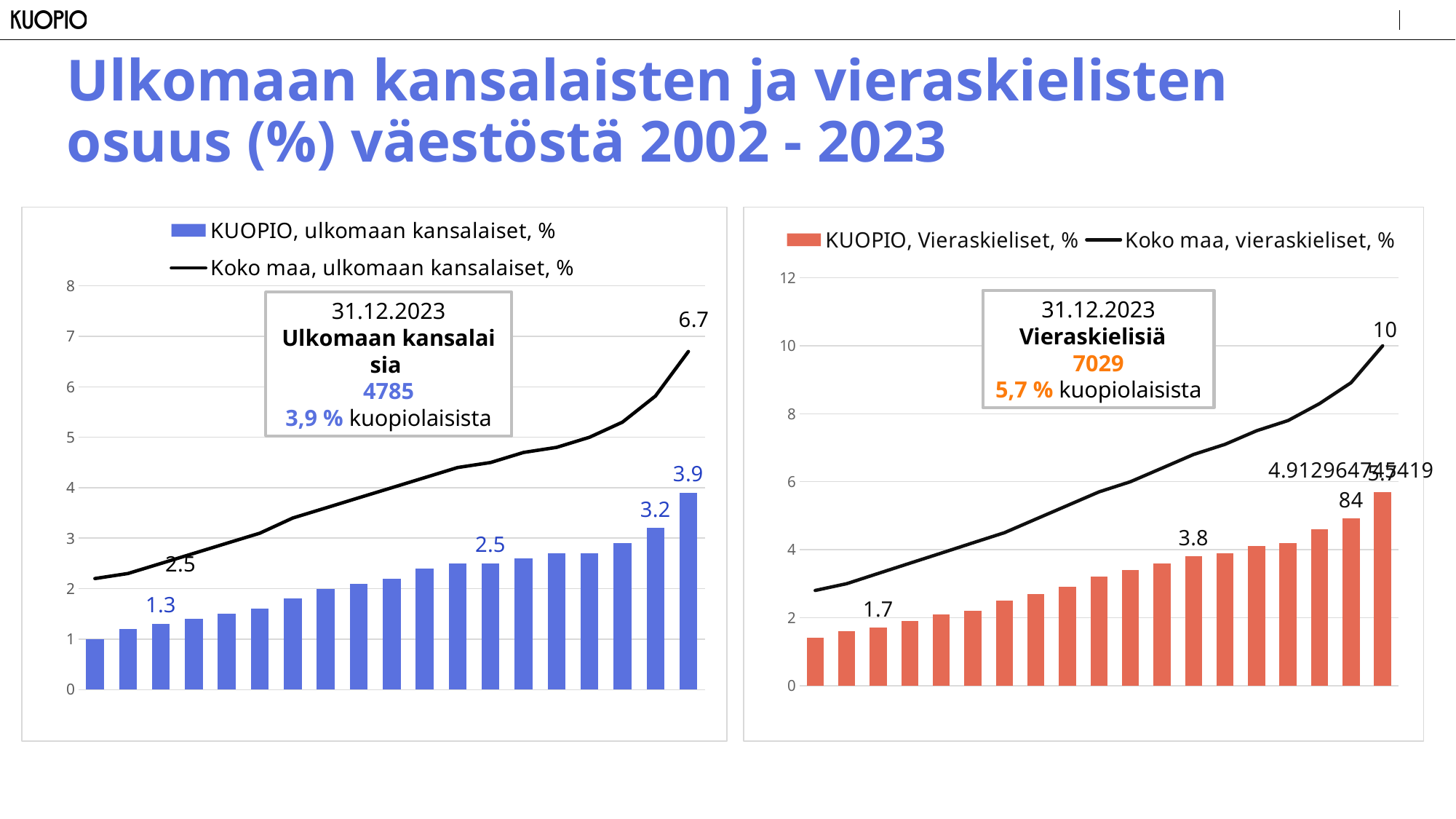
How many series does the legend of the right chart (Vieraskieliset) list? 2 In the right chart, what is the final value of the 'Koko maa, vieraskieliset, %' line? 10 What kind of chart is the left chart, 'KUOPIO, ulkomaan kansalaiset, %'? A bar chart combined with a line In the right chart, what is the value of the third bar for KUOPIO, Vieraskieliset, %? 1.7 In the left chart, which bar is the highest for KUOPIO, ulkomaan kansalaiset, %? The rightmost (last) bar In the right chart, is the value of the first bar for KUOPIO, Vieraskieliset, % greater or less than 2? less In the right chart, do the KUOPIO, Vieraskieliset, % bars rise or fall from left to right? rise In the left chart, which is larger at the end of the period: the Koko maa line or the KUOPIO bar? Koko maa line In the left chart, what is the value of the last (rightmost) bar for KUOPIO, ulkomaan kansalaiset, %? 3.9 According to the text box in the right chart, how many vieraskielisiä were there on 31.12.2023? 7029 In the left chart, what is the final value of the 'Koko maa, ulkomaan kansalaiset, %' line? 6.7 In the left chart, what is the difference between the final Koko maa value (6.7) and the final KUOPIO bar value (3.9)? 2.8